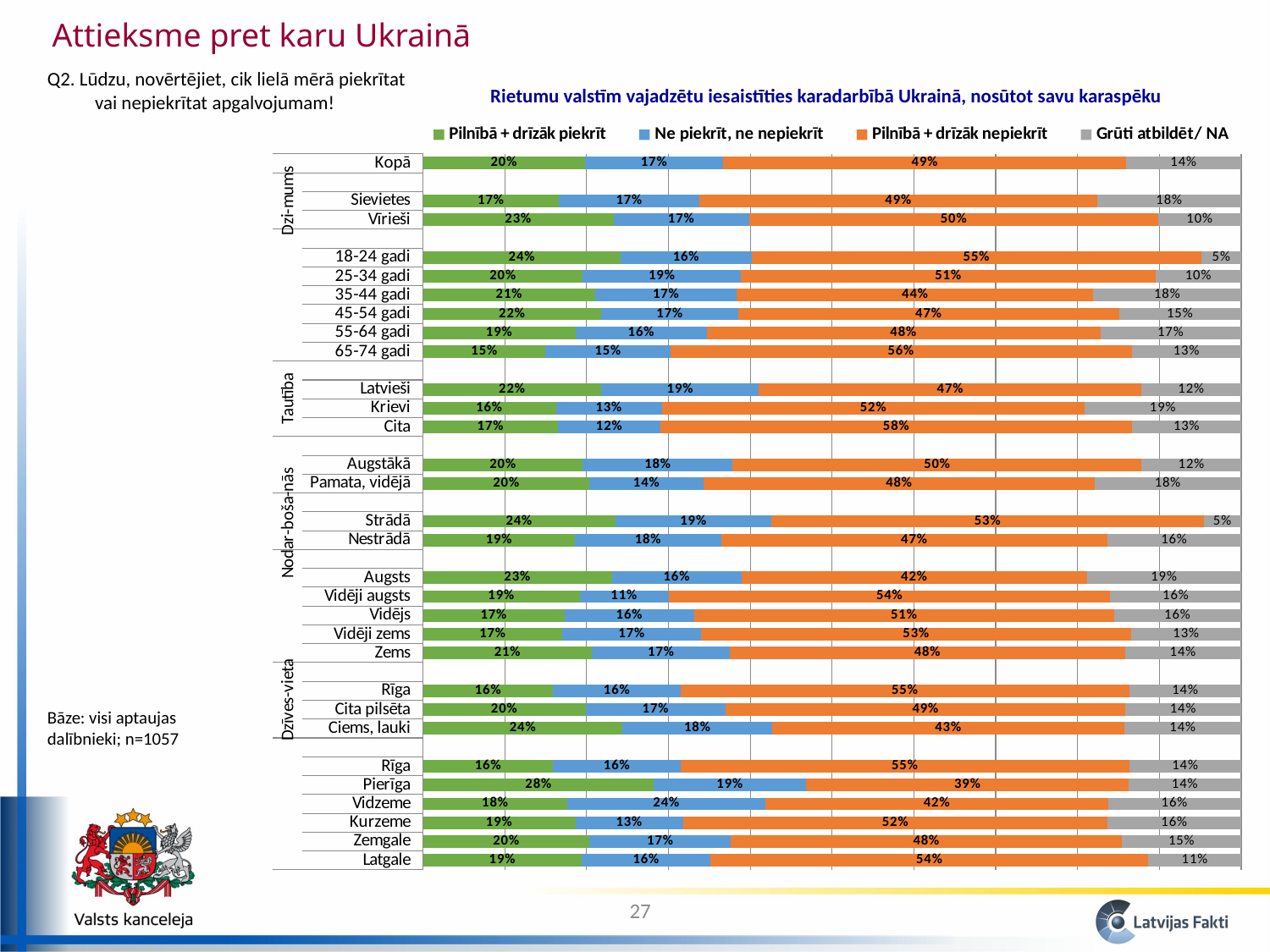
What is the value of 'Pilnībā + drīzāk nepiekrīt' for Kopā? 49% What is the value of 'Pilnībā + drīzāk piekrīt' for Pierīga? 28% Which category has the highest value for 'Pilnībā + drīzāk nepiekrīt'? Cita Which has a larger 'Pilnībā + drīzāk piekrīt' value, Strādā or Nestrādā? Strādā What is the value of 'Ne piekrīt, ne nepiekrīt' for Vidzeme? 24% What is the difference between the 'Pilnībā + drīzāk nepiekrīt' values for Rīga and Ciems, lauki? 12% What is the title of the chart? Rietumu valstīm vajadzētu iesaistīties karadarbībā Ukrainā, nosūtot savu karaspēku What is the value of 'Grūti atbildēt/ NA' for 18-24 gadi? 5% Which category has the lowest value for 'Pilnībā + drīzāk nepiekrīt'? Pierīga What is the difference between the 'Pilnībā + drīzāk nepiekrīt' values for Vīrieši and Sievietes? 1% What kind of chart is shown on the slide? Stacked bar chart How many series does the legend list? 4